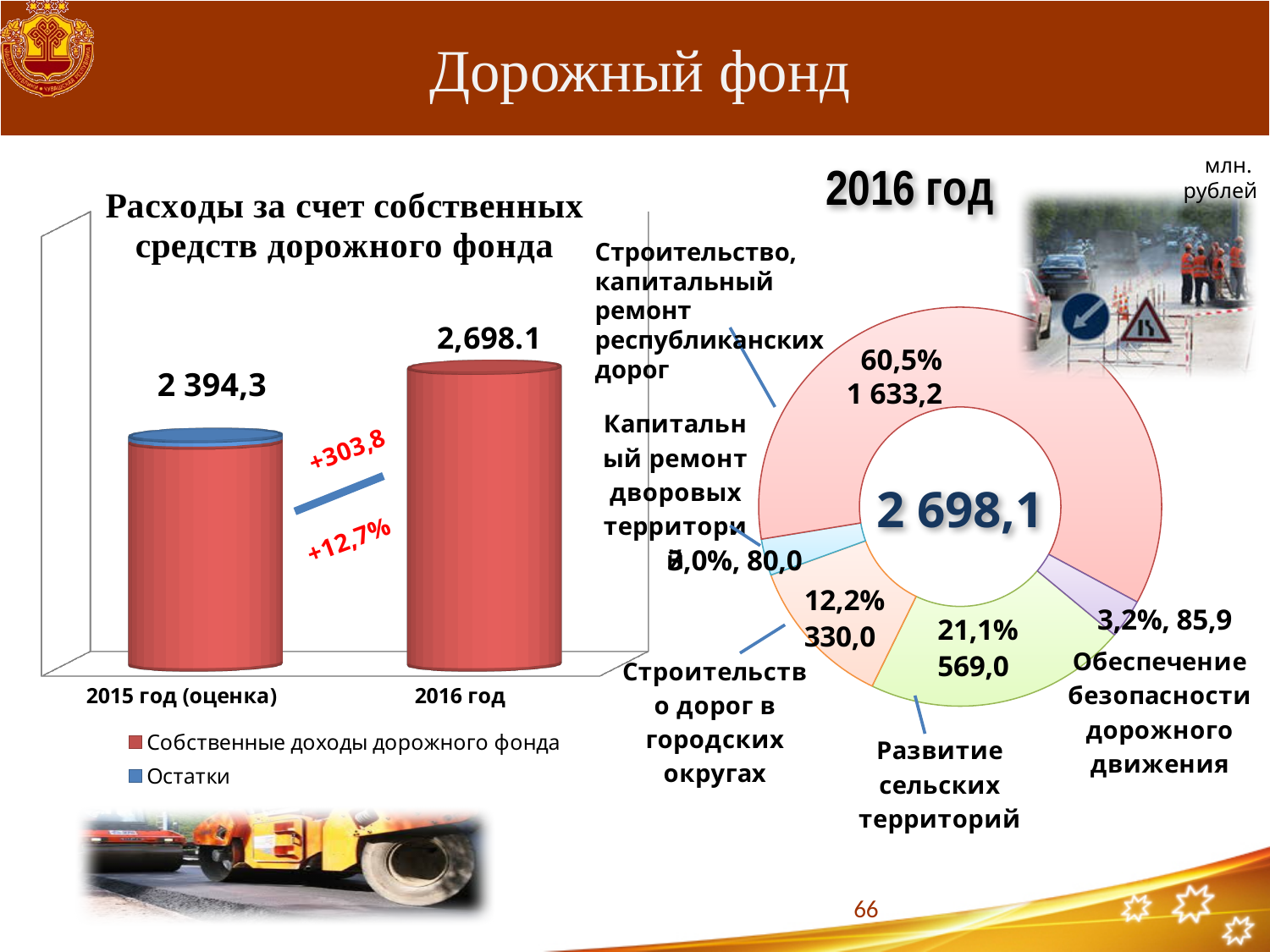
On the bar chart 'Расходы за счет собственных средств дорожного фонда', what kind of chart is it? bar chart On the bar chart 'Расходы за счет собственных средств дорожного фонда', what is the value for 2015 год (оценка)? 2 394,3 On the bar chart 'Расходы за счет собственных средств дорожного фонда', how many series does the legend list? 2 On the doughnut chart '2016 год', what share is shown for 'Строительство, капитальный ремонт республиканских дорог'? 60,5% On the doughnut chart '2016 год', what share is shown for 'Обеспечение безопасности дорожного движения'? 3,2% On the doughnut chart '2016 год', what total is shown in the centre of the chart? 2 698,1 On the doughnut chart '2016 год', what value is shown for 'Развитие сельских территорий'? 569,0 On the bar chart 'Расходы за счет собственных средств дорожного фонда', which year has the higher value? 2016 год On the bar chart 'Расходы за счет собственных средств дорожного фонда', what is the value for 2016 год? 2,698.1 On the doughnut chart '2016 год', what value is shown for 'Строительство дорог в городских округах'? 330,0 On the bar chart 'Расходы за счет собственных средств дорожного фонда', what increase is annotated between 2015 and 2016 in absolute terms? +303,8 On the doughnut chart '2016 год', which category has the largest share? Строительство, капитальный ремонт республиканских дорог